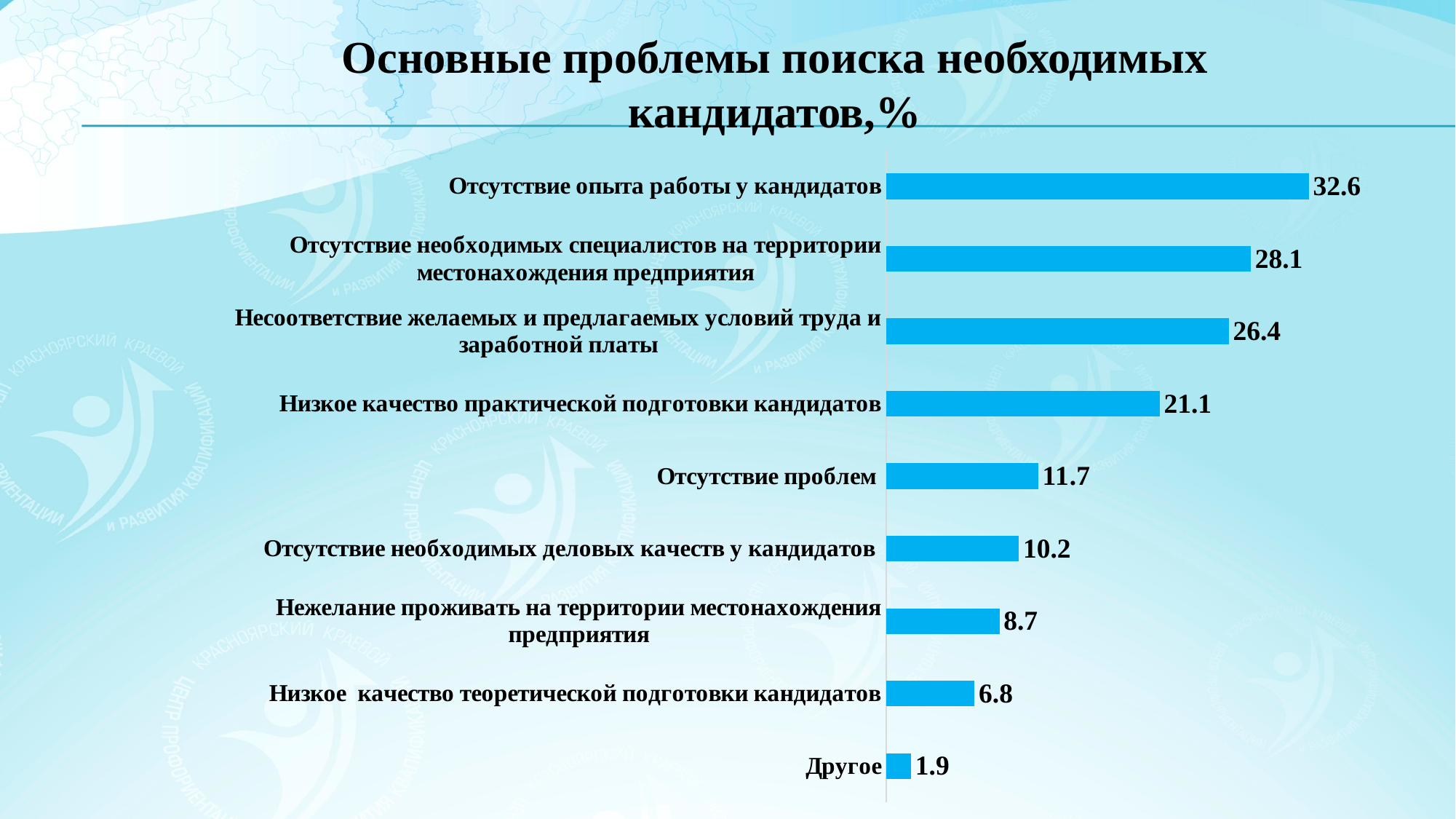
What is the value for "Отсутствие опыта работы у кандидатов"? 32.6 What is the value for "Отсутствие проблем"? 11.7 What is the value for "Низкое качество теоретической подготовки кандидатов"? 6.8 What kind of chart is shown on the slide? Bar chart What is the difference between the values for "Отсутствие опыта работы у кандидатов" and "Отсутствие необходимых специалистов на территории местонахождения предприятия"? 4.5 What is the value for "Нежелание проживать на территории местонахождения предприятия"? 8.7 How many categories are shown in the chart? 9 Which category has the highest value? Отсутствие опыта работы у кандидатов Which is larger: the value for "Отсутствие проблем" or the value for "Отсутствие необходимых деловых качеств у кандидатов"? Отсутствие проблем What is the difference between the values for "Низкое качество практической подготовки кандидатов" and "Низкое качество теоретической подготовки кандидатов"? 14.3 What is the title of the chart? Основные проблемы поиска необходимых кандидатов,% Which category has the lowest value? Другое